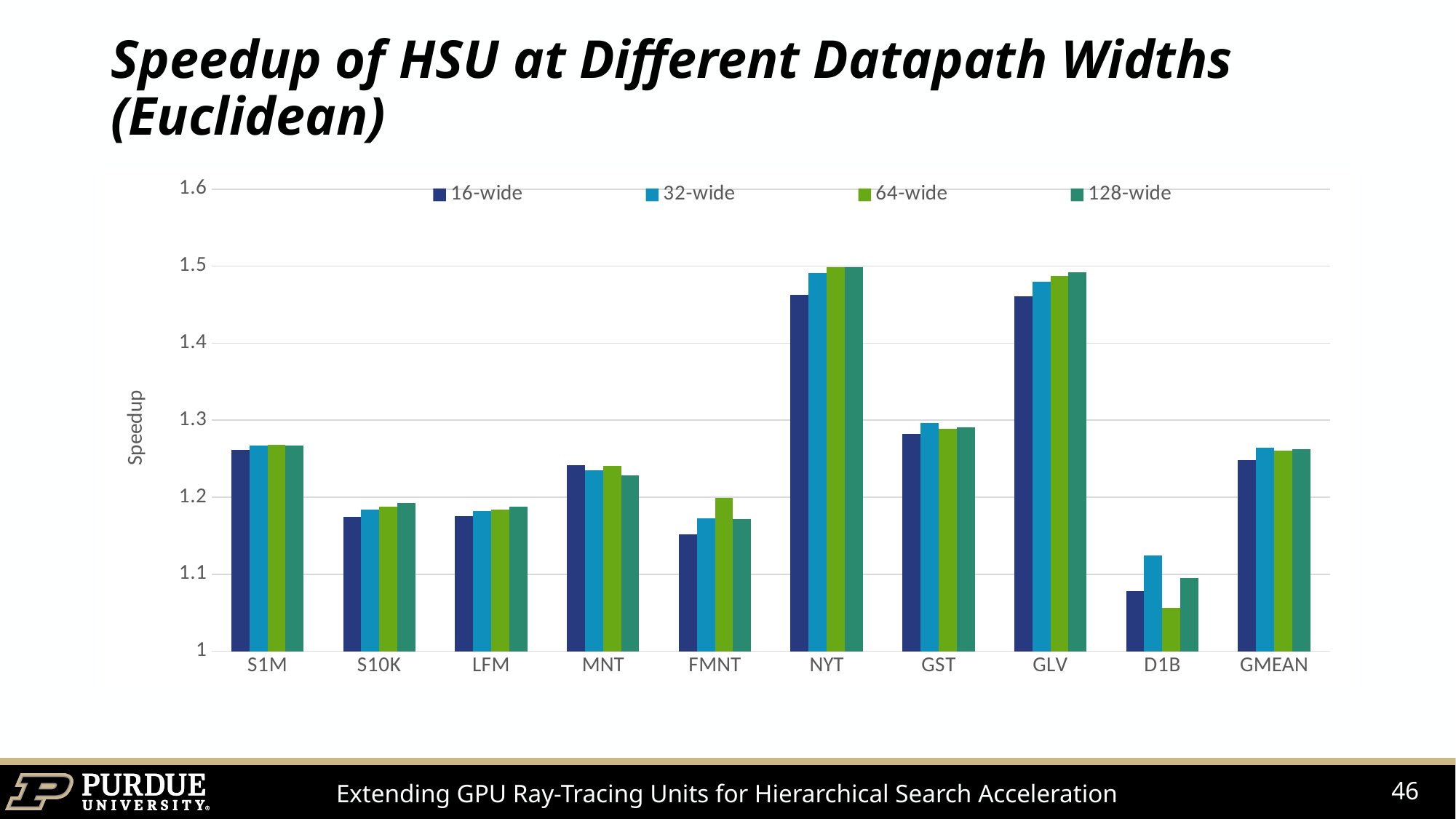
Is the 64-wide speedup for FMNT greater or less than 1.3? less Is the 32-wide speedup for D1B greater or less than 1.2? less Is the 16-wide speedup for S1M greater or less than 1.2? greater How many categories are shown along the x axis? 10 How many series does the legend list? 4 What is the label on the y axis? Speedup What kind of chart is shown on the slide? bar chart Which category has the lowest speedup values across all datapath widths? D1B For FMNT, which is larger: the 64-wide speedup or the 16-wide speedup? 64-wide For D1B, which is larger: the 32-wide speedup or the 64-wide speedup? 32-wide